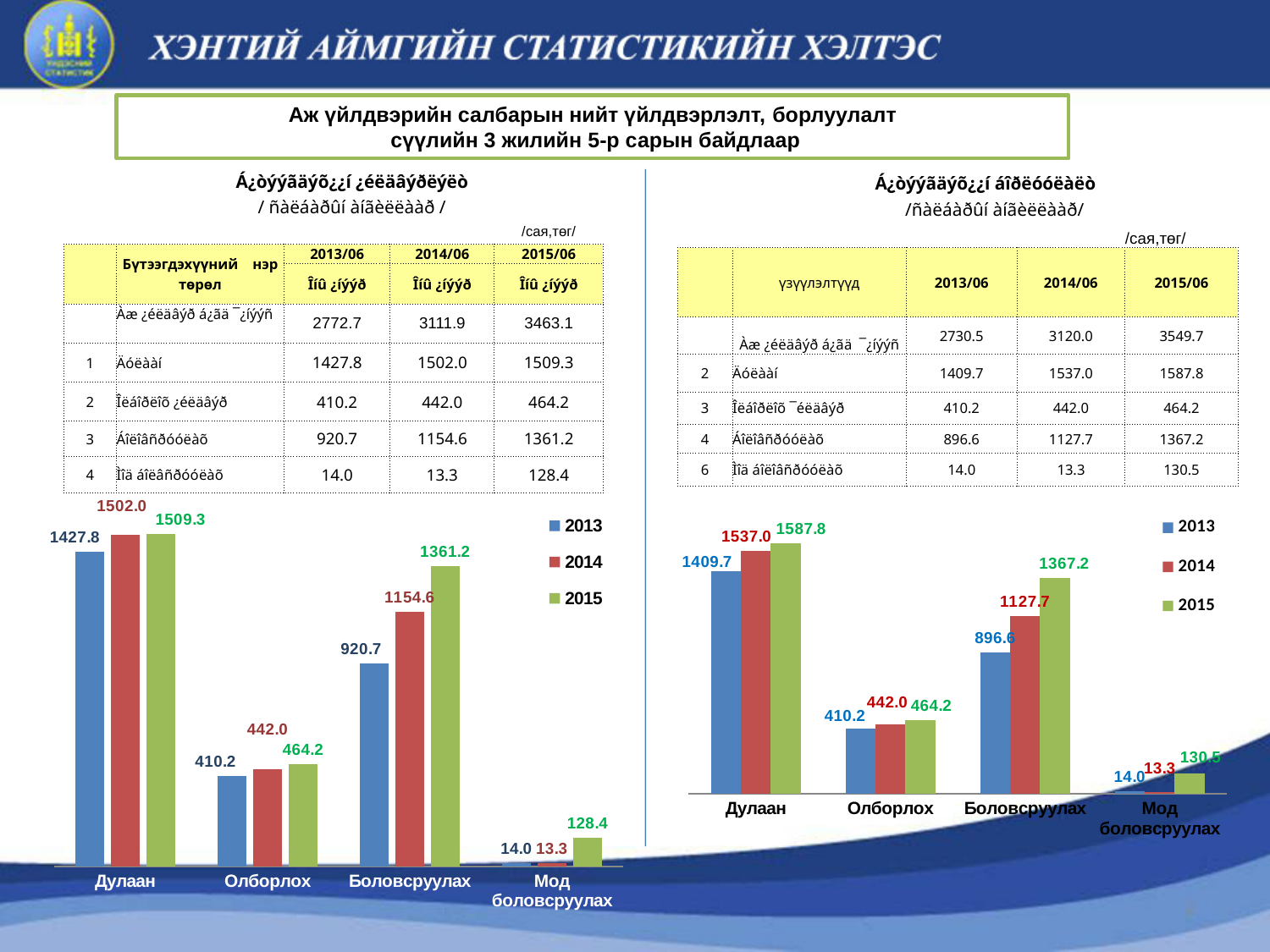
In the left chart, what is the value for Дулаан in 2015? 1509.3 In the left chart, which category has the lowest value in 2013? Мод боловсруулах In the right chart, which category has the highest value in 2015? Дулаан How many categories are shown on the x axis of the left chart? 4 What type of chart is the left chart? Bar chart In the right chart, which is larger: the 2013 value for Боловсруулах or the 2013 value for Олборлох? Боловсруулах In the left chart, what is the difference between the 2015 and 2013 values for Боловсруулах? 440.5 In the right chart, what is the value for Боловсруулах in 2014? 1127.7 How many series does the legend of the right chart list? 3 In the right chart, do the values for Олборлох rise or fall from 2013 to 2015? Rise In the right chart, what is the difference between the 2015 and 2014 values for Дулаан? 50.8 In the left chart, what is the value for Мод боловсруулах in 2015? 128.4